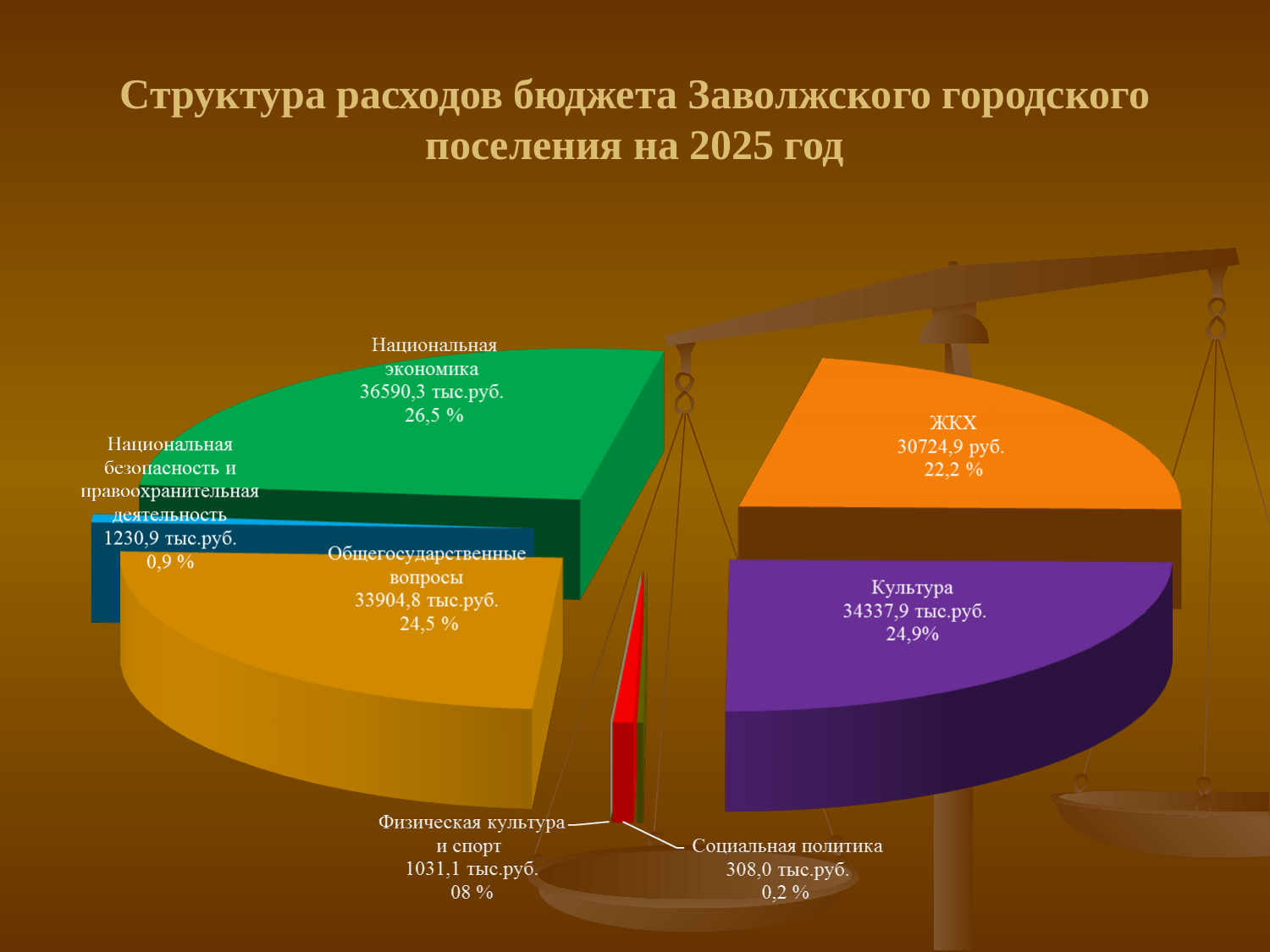
How many slices does the pie chart have? 7 Which category has the smallest share of expenditures? Социальная политика What is the title of the slide? Структура расходов бюджета Заволжского городского поселения на 2025 год What is the difference in тыс.руб. between Национальная экономика and Культура? 2252,4 тыс.руб. What share of the pie does Общегосударственные вопросы represent? 24,5 % What share of the pie does ЖКХ represent? 22,2 % What is the value shown for Социальная политика? 308,0 тыс.руб. Which is larger, Культура or Общегосударственные вопросы? Культура What is the value shown for Национальная экономика? 36590,3 тыс.руб. Which category has the largest share of expenditures? Национальная экономика What is the value shown for Культура? 34337,9 тыс.руб. What kind of chart is shown on the slide? Pie chart